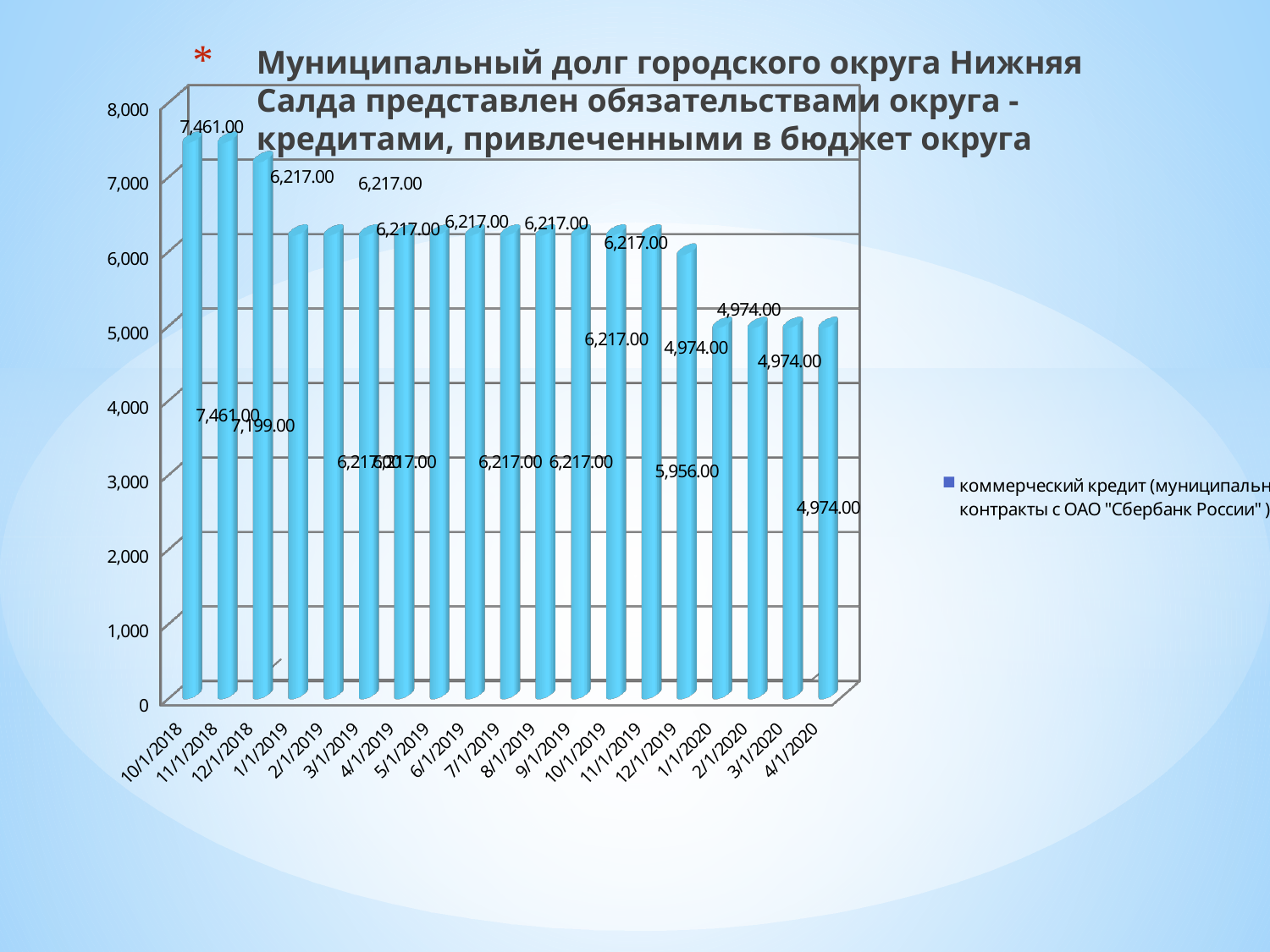
Do the values generally rise or fall from 10/1/2018 to 4/1/2020? fall What is the value for 12/1/2018? 7,199.00 What type of chart is shown on the slide? bar chart How many dates (categories) are plotted along the x axis? 19 Which is larger, the value for 12/1/2018 or the value for 12/1/2019? 12/1/2018 What is the highest value shown in the chart? 7,461.00 What is the difference between the value for 10/1/2018 and the value for 4/1/2020? 2,487.00 What is the value for 4/1/2020? 4,974.00 What is the lowest value shown in the chart? 4,974.00 What is the value for 12/1/2019? 5,956.00 What is the value for 6/1/2019? 6,217.00